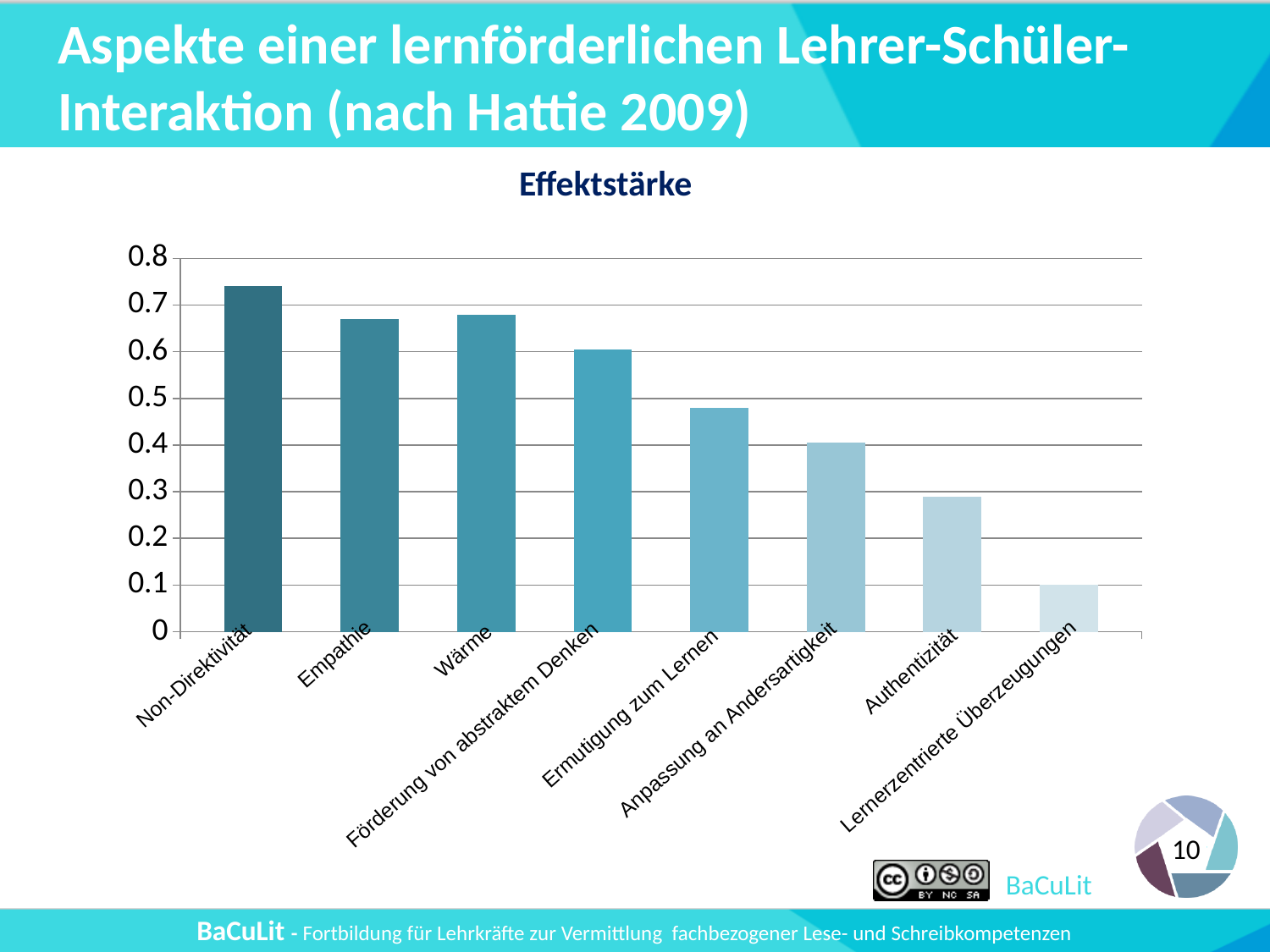
What kind of chart is shown on the slide? bar chart What is the title of the chart? Effektstärke Which is larger, the value for Authentizität or the value for Ermutigung zum Lernen? Ermutigung zum Lernen Which is larger, the value for Empathie or the value for Anpassung an Andersartigkeit? Empathie Is the value for Förderung von abstraktem Denken greater or less than 0.5? greater Which category has the highest value? Non-Direktivität Which category has the lowest value? Lernerzentrierte Überzeugungen How many categories are shown in the chart? 8 Is the value for Non-Direktivität greater or less than 0.7? greater Do the values generally rise or fall from left to right along the x axis? fall Is the value for Ermutigung zum Lernen greater or less than 0.5? less